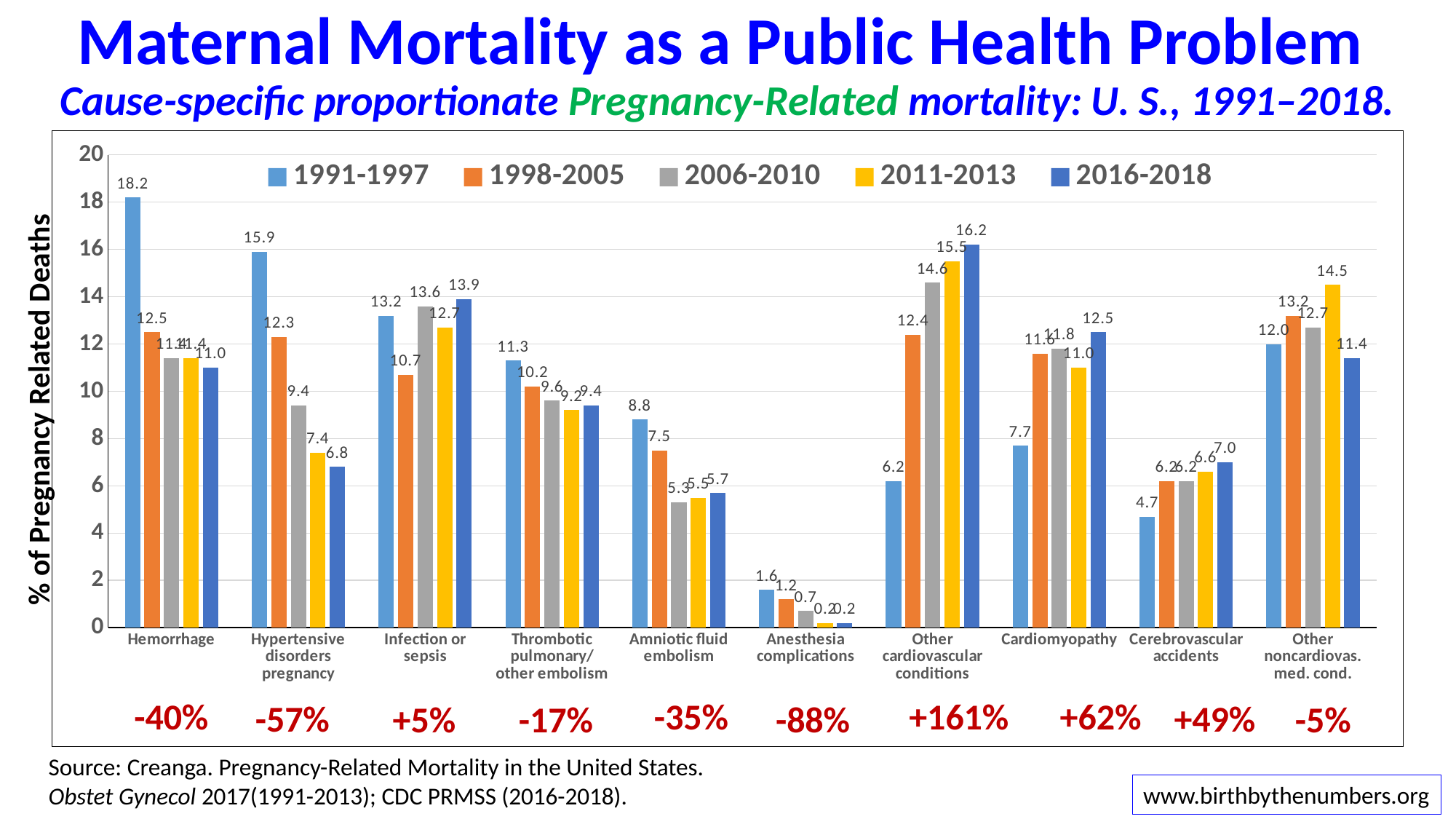
How many cause categories are shown on the x axis? 10 What kind of chart is shown on the slide? Bar chart How many series does the legend list? 5 Which category has the highest value in the 1991-1997 series? Hemorrhage What is the value for Cardiomyopathy in the 1991-1997 series? 7.7 What is the value for Other cardiovascular conditions in the 2016-2018 series? 16.2 What percentage change is printed below the Other cardiovascular conditions category? +161% What is the value for Hemorrhage in the 1991-1997 series? 18.2 What is the difference between the 1991-1997 and 2016-2018 values for Hypertensive disorders pregnancy? 9.1 Which category has the lowest value in the 2016-2018 series? Anesthesia complications What is the value for Anesthesia complications in the 1998-2005 series? 1.2 Which is larger for Other noncardiovas. med. cond.: the 2011-2013 value or the 2016-2018 value? 2011-2013